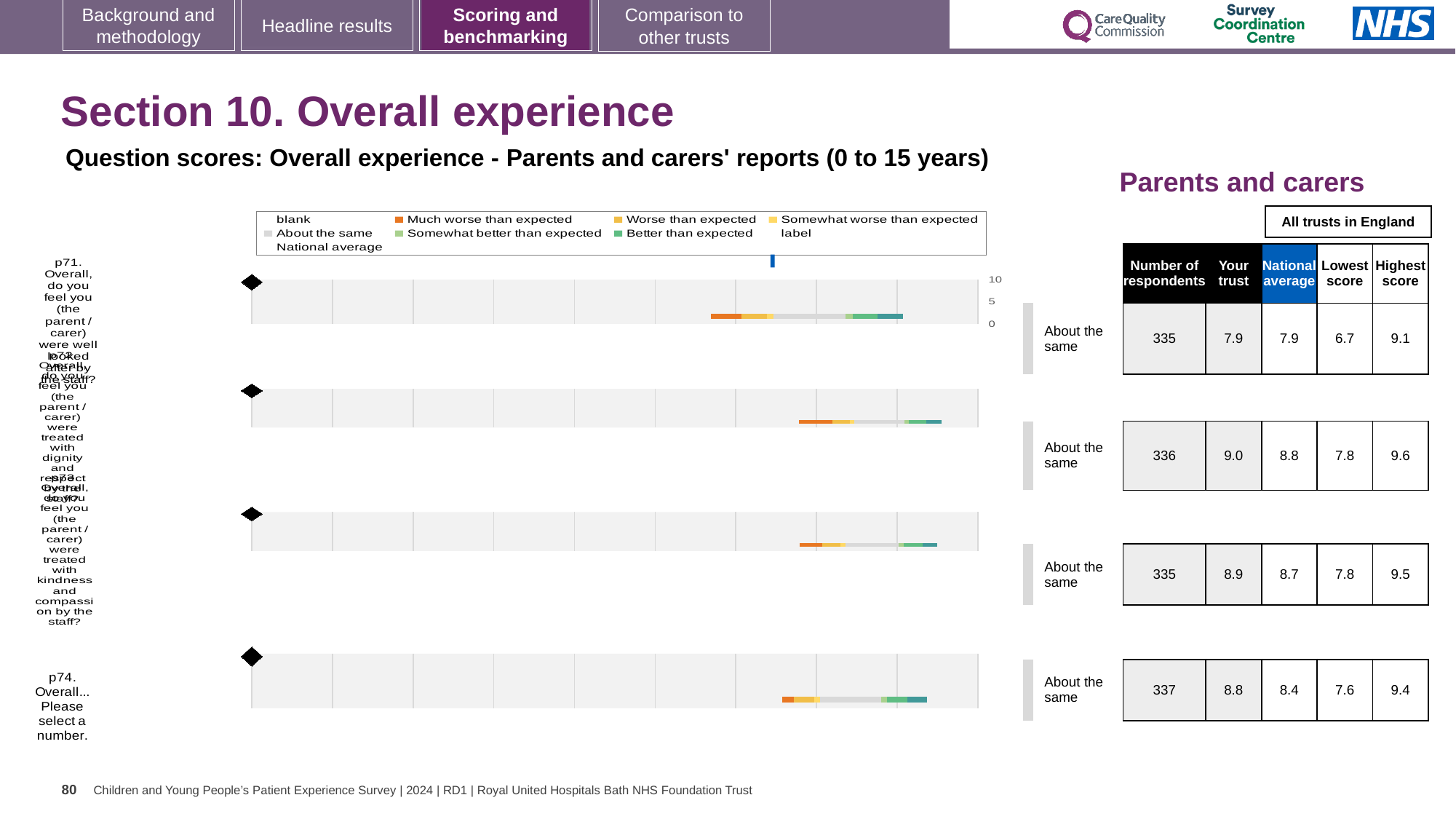
Which question has the lowest 'Your trust' score? p71 (7.9) For p74, what is the difference between the 'Your trust' score and the national average? 0.4 How many questions (bars) are plotted in the chart? 4 What benchmark category is shown for all four questions? About the same What is the highest score across all trusts in England for the second question row? 9.6 What is the 'Your trust' score for p74 (Overall... Please select a number)? 8.8 How many respondents answered p74? 337 What is the national average score for the second question row in the chart? 8.8 Which question row has the highest 'Your trust' score? the second row (9.0) For the third question row, is the 'Your trust' score or the national average higher? Your trust (8.9) What kind of chart is shown on the slide? bar chart What colour represents 'Much worse than expected' in the legend? orange